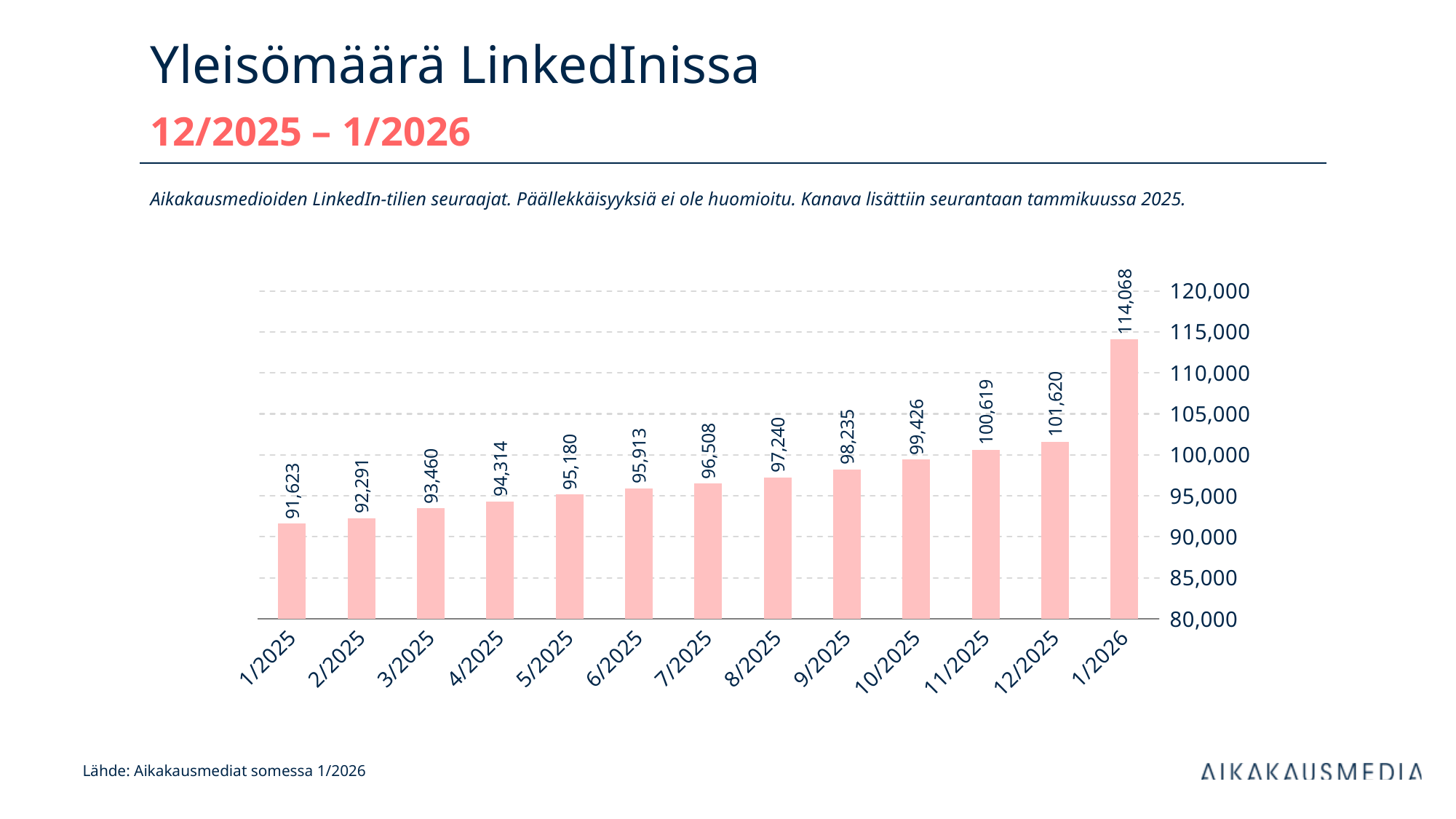
What is the value for 12/2025? 101,620 What is the difference between the values for 12/2025 and 1/2025? 9,997 What is the value for 6/2025? 95,913 Is the value for 11/2025 greater or less than 100,000? greater Which is larger, the value for 3/2025 or the value for 9/2025? 9/2025 Do the values rise or fall from 1/2025 to 1/2026? rise What is the difference between the values for 1/2026 and 12/2025? 12,448 How many months are shown on the x axis? 13 What kind of chart is shown on the slide? bar chart What is the value for 1/2026? 114,068 Which month has the lowest value? 1/2025 Which month has the highest value? 1/2026